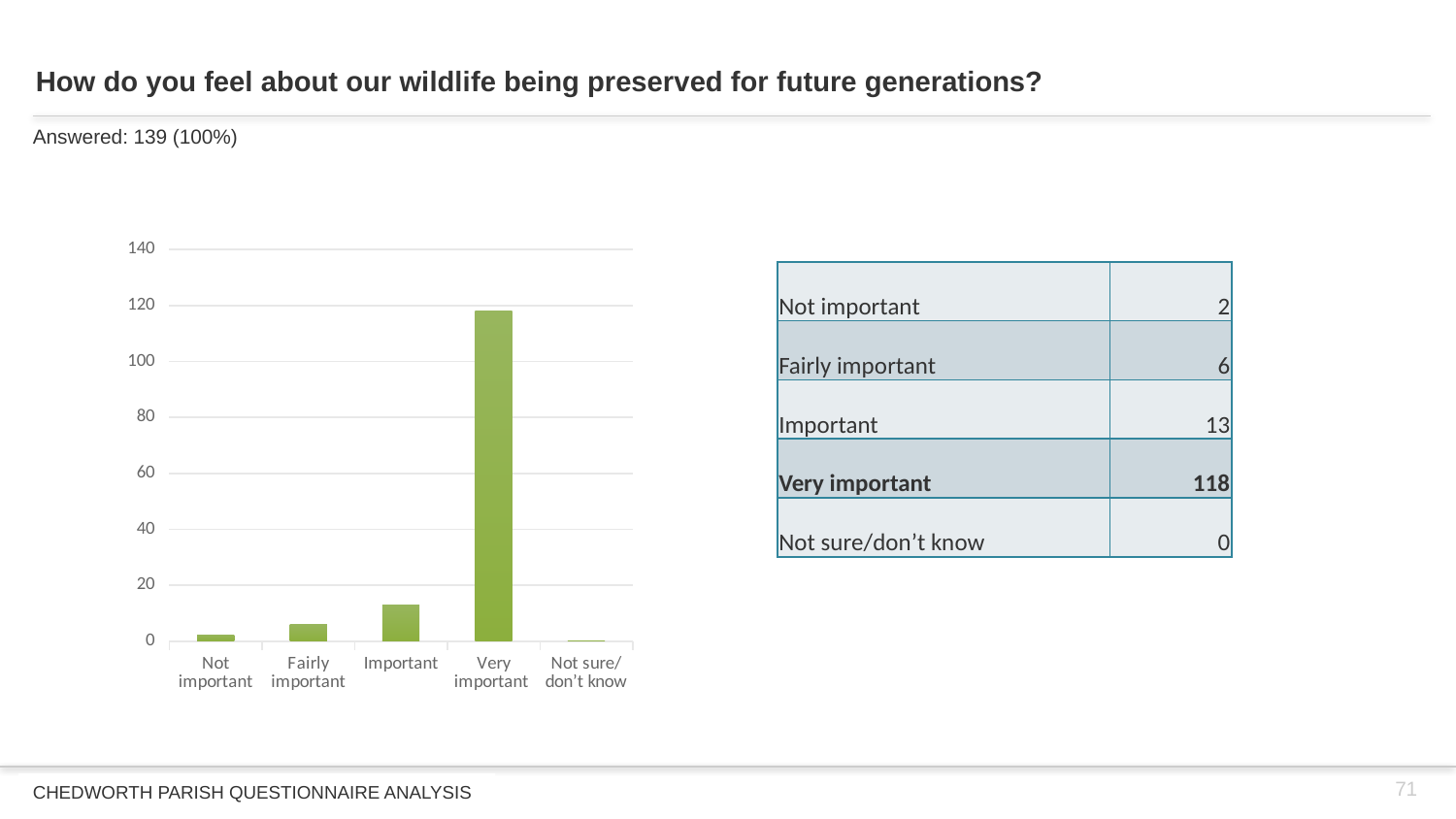
Is the value for Important greater or less than 20? less How many categories are shown on the x axis of the bar chart? 5 According to the table on the slide, what is the value for Not important? 2 According to the table on the slide, what is the value for Important? 13 Is the value for Very important greater or less than 100? greater Which category has the lowest value in the chart? Not sure/don't know According to the table on the slide, what is the value for Very important? 118 What is the difference between the values for Very important and Important, using the figures in the table? 105 Which is larger, the value for Important or the value for Fairly important? Important What kind of chart is shown on the slide? bar chart Which category has the highest bar in the chart? Very important According to the table on the slide, what is the value for Fairly important? 6